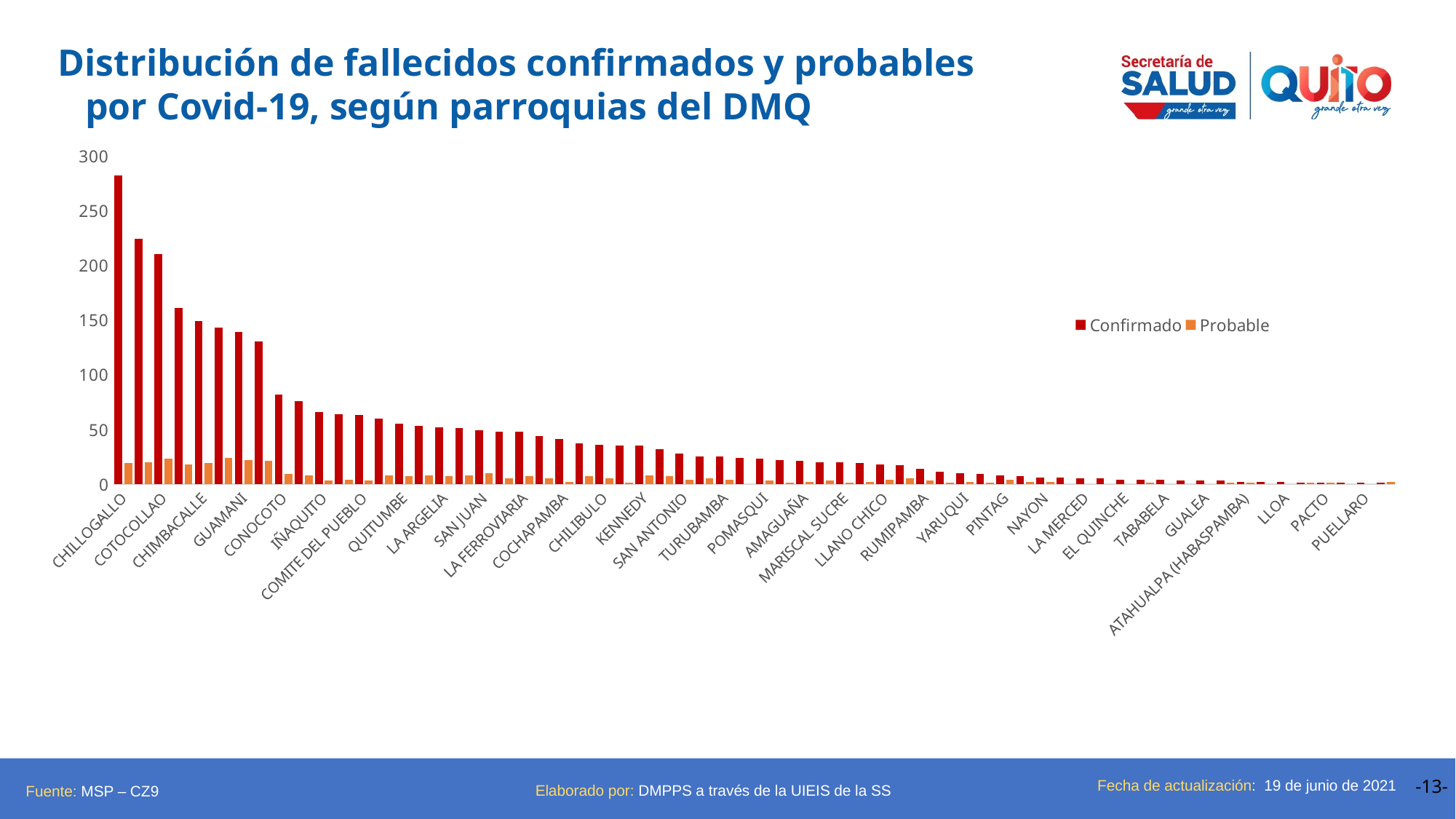
For CHILLOGALLO, which is larger: the Confirmado value or the Probable value? Confirmado Do the Confirmado values generally rise or fall from left to right along the x axis? fall What kind of chart is shown on the slide? bar chart How many series does the legend list? 2 Which is larger: the Confirmado value for CHILLOGALLO or the Confirmado value for PUELLARO? CHILLOGALLO Is the Confirmado value for CHILLOGALLO greater or less than 250? greater Which parroquia has the highest number of confirmed (Confirmado) deaths? CHILLOGALLO Is the Confirmado value for PUELLARO greater or less than 50? less What is the highest value shown on the vertical axis? 300 What are the two series named in the legend? Confirmado and Probable Is the Probable value for CHILLOGALLO greater or less than 50? less What is the title of the chart on the slide? Distribución de fallecidos confirmados y probables por Covid-19, según parroquias del DMQ